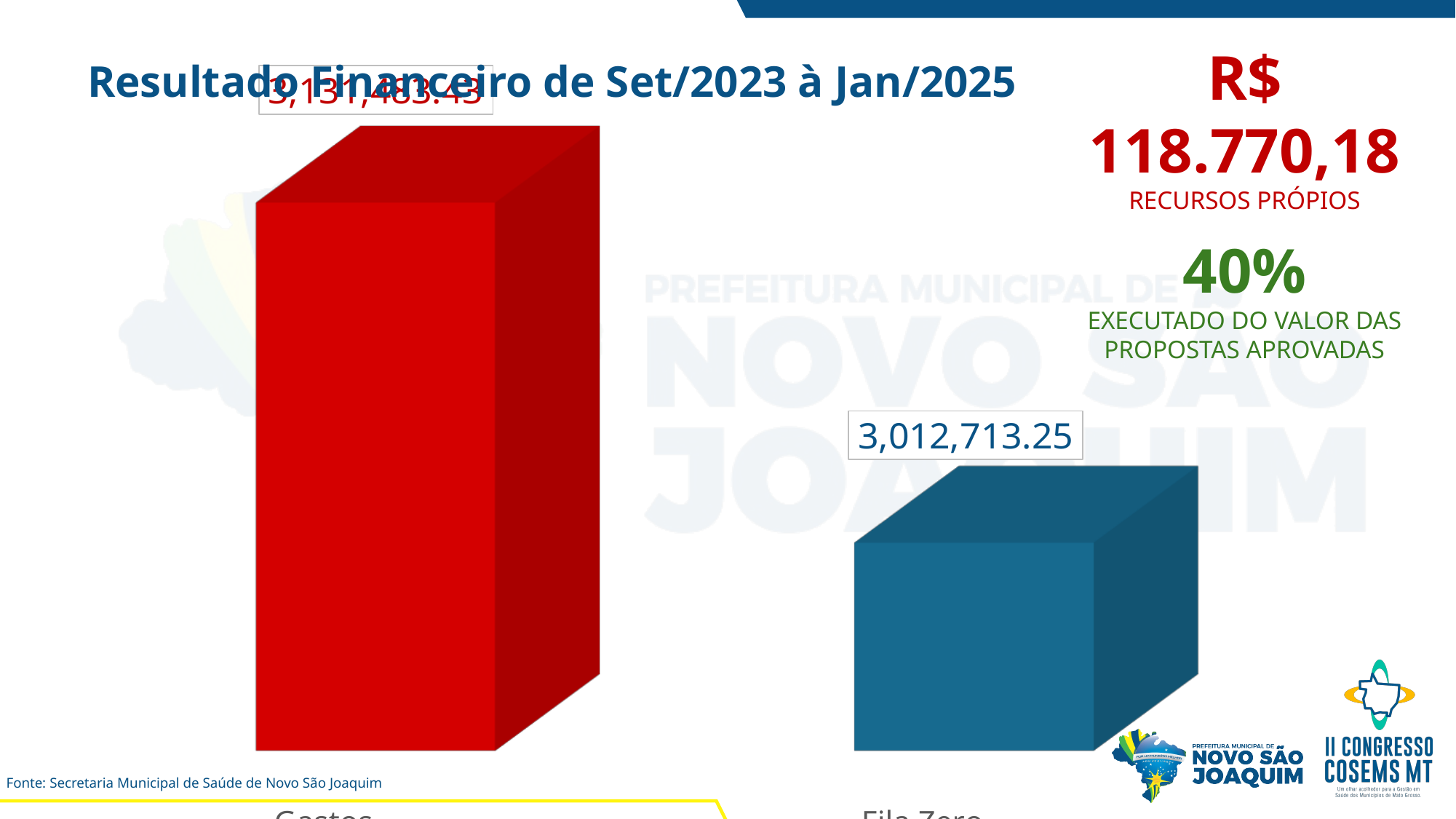
What is the value shown for Fila Zero? 3,012,713.25 Which category has the highest bar? Gastos How many categories are plotted in the chart? 2 What colour is the bar for Gastos? red Which category has the lowest bar? Fila Zero What kind of chart is shown on the slide? bar chart Which is larger, the value for Gastos or the value for Fila Zero? Gastos